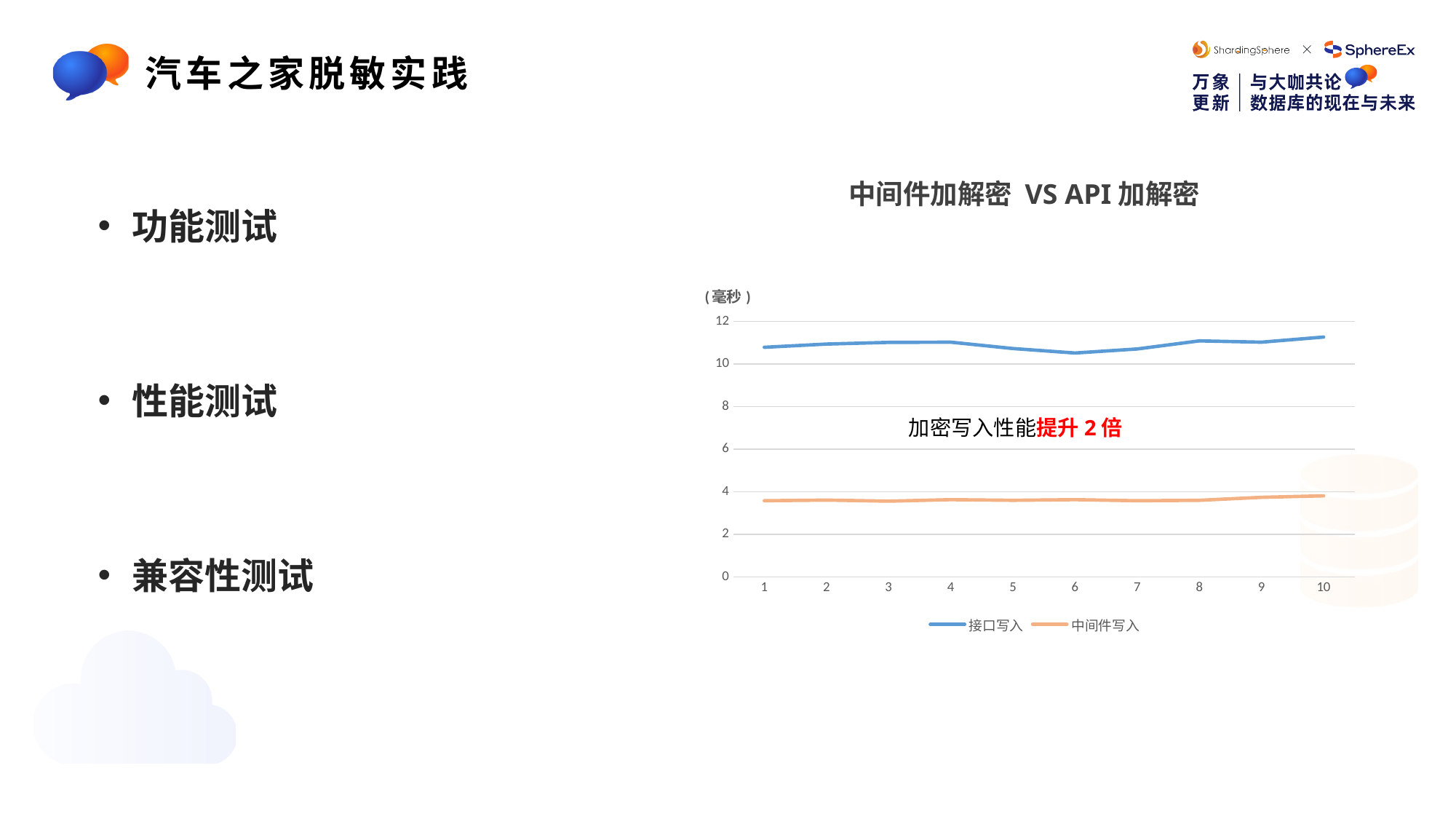
At point 3, which series has the higher value, 接口写入 or 中间件写入? 接口写入 Is the value for 接口写入 at point 10 greater or less than 12? less How many points are plotted along the x axis for each series? 10 At point 8, which series has the lower value, 接口写入 or 中间件写入? 中间件写入 What unit is shown for the y axis of the chart? 毫秒 Is the value for 中间件写入 at point 1 greater or less than 2? greater What is the title of the chart? 中间件加解密 VS API 加解密 How many series does the chart legend list? 2 Is the value for 中间件写入 at point 5 greater or less than 4? less What kind of chart is shown on the slide? line chart